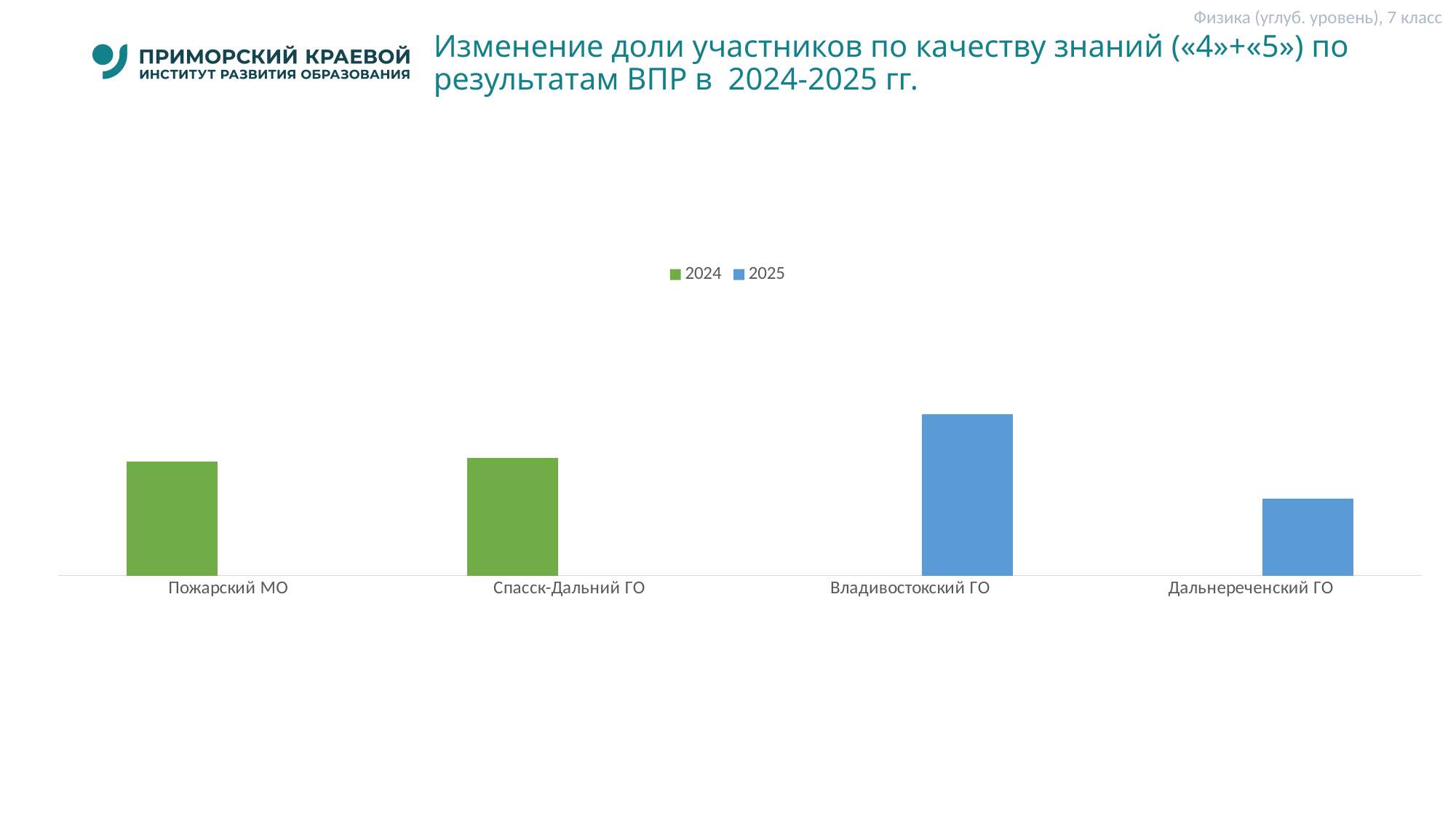
Which series is shown in green in the chart? 2024 Which bar is taller: Владивостокский ГО or Спасск-Дальний ГО? Владивостокский ГО How many series does the chart legend list? 2 Which bar is taller: Владивостокский ГО or Дальнереченский ГО? Владивостокский ГО Which category has the shortest bar in the chart? Дальнереченский ГО How many categories are shown on the x axis of the chart? 4 What kind of chart is shown on the slide? Bar chart Which category has the tallest bar in the chart? Владивостокский ГО What are the two series listed in the chart legend? 2024 and 2025 Which bar is taller: Пожарский МО or Дальнереченский ГО? Пожарский МО